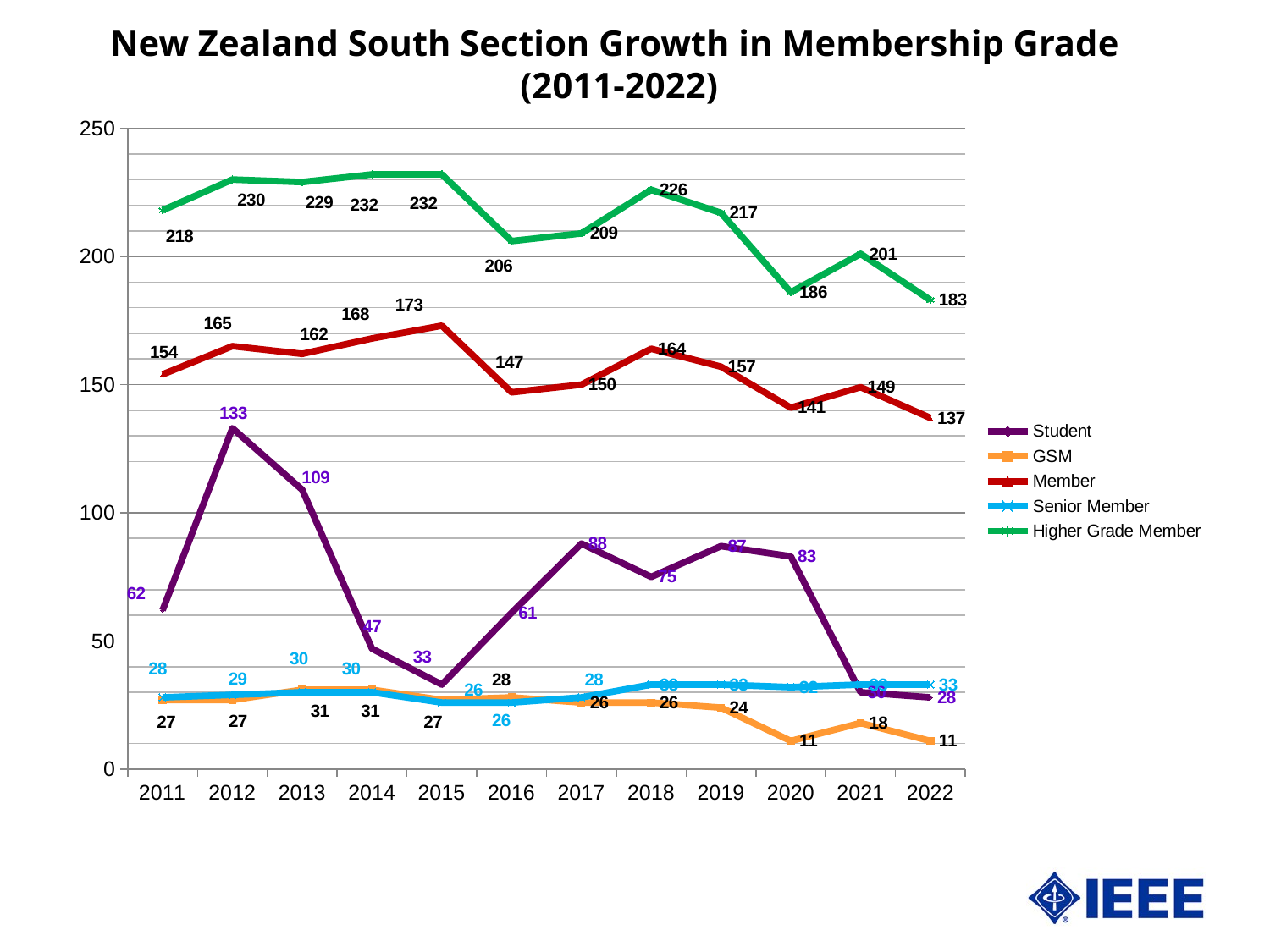
What is the value for Higher Grade Member in 2012? 230 What is the value for GSM in 2020? 11 In which year is the Member series highest? 2015 Which is larger, the Member value in 2018 or in 2019? 2018 How many series does the legend list? 5 What is the value for Student in 2012? 133 In which year is the Member series lowest? 2022 What is the difference between the Higher Grade Member values in 2011 and 2022? 35 Is the value for Senior Member in 2019 greater or less than 50? less How many years are plotted on the x axis? 12 What is the value for Member in 2015? 173 In which year is the Student series highest? 2012